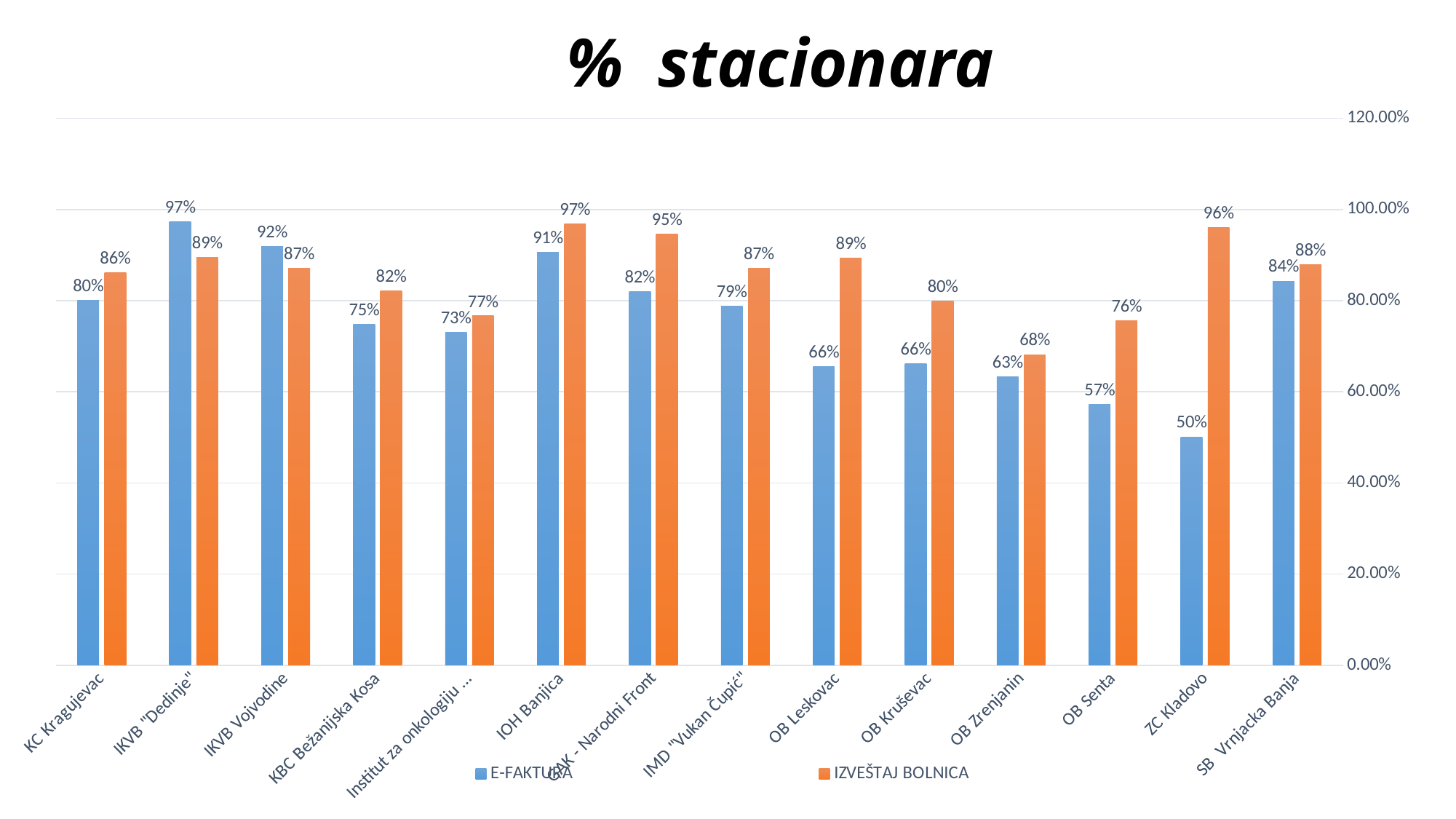
What is the difference between the IZVEŠTAJ BOLNICA and E-FAKTURA values for ZC Kladovo? 46 percentage points Which institution has the highest E-FAKTURA value? IKVB "Dedinje" Which colour represents the IZVEŠTAJ BOLNICA series? Orange For IKVB Vojvodine, which is larger: the E-FAKTURA value or the IZVEŠTAJ BOLNICA value? E-FAKTURA What is the E-FAKTURA value for ZC Kladovo? 50% What is the IZVEŠTAJ BOLNICA value for OB Leskovac? 89% Which institution has the lowest IZVEŠTAJ BOLNICA value? OB Zrenjanin What type of chart is shown on the slide? Bar chart How many institutions (categories) are shown on the x axis? 14 What is the title of the chart? % stacionara Is the E-FAKTURA value for OB Senta greater or less than 60.00%? less How many series does the legend list? 2